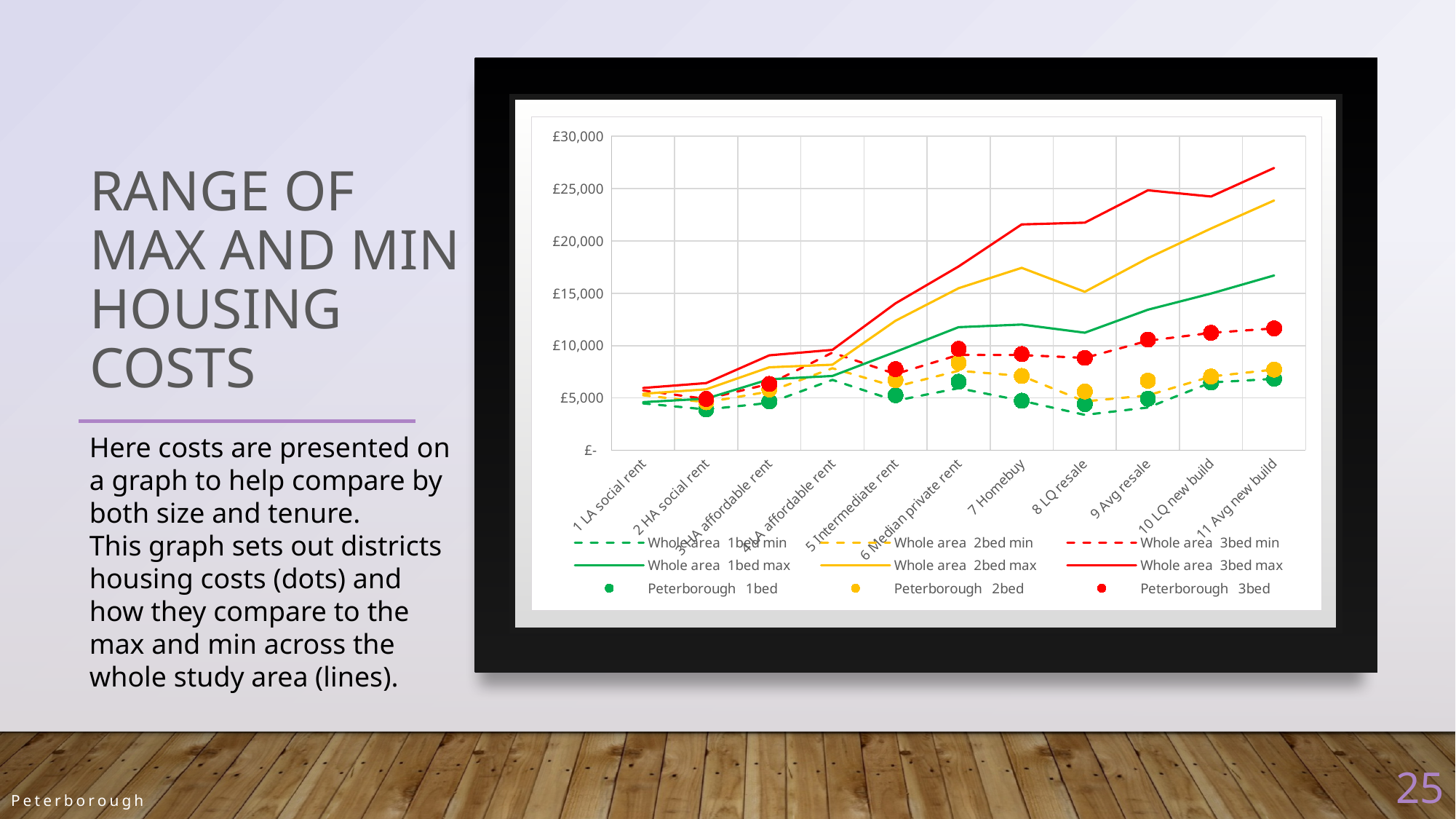
Does the Whole area 3bed max line rise or fall from 8 LQ resale to 11 Avg new build? rise How many categories are shown along the x axis of the chart? 11 What colour are the Peterborough 3bed dots in the chart? red Is the value of Whole area 3bed max for 7 Homebuy greater or less than £20,000? greater Is the Peterborough 3bed value for 11 Avg new build greater or less than £10,000? greater Which category has the highest value for Whole area 3bed max? 11 Avg new build How many series does the chart's legend list? 9 Is the value of Whole area 1bed max for 11 Avg new build greater or less than £15,000? greater At 11 Avg new build, which is larger: Whole area 3bed max or Whole area 2bed max? Whole area 3bed max What kind of chart is shown on the slide? line chart